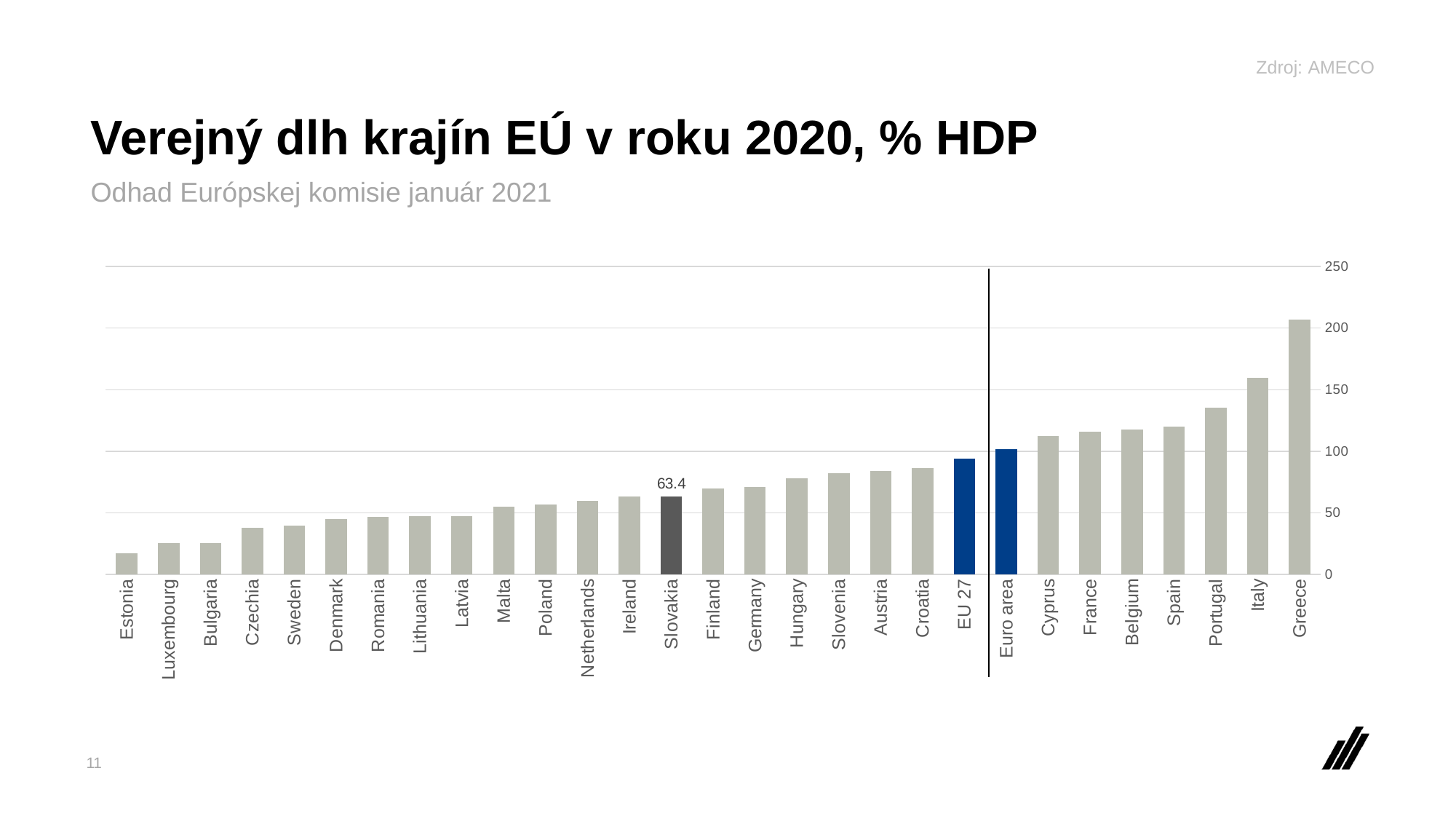
How many categories (bars) are shown on the x axis? 29 Which country has the highest public debt in the chart? Greece What type of chart is shown on the slide? bar chart Which has a larger value, Estonia or Luxembourg? Luxembourg Is the value for Italy greater or less than 150? greater Which has a larger value, Greece or Italy? Greece Do the values generally rise or fall from left to right along the x axis? rise What is the value shown for Slovakia? 63.4 Which country has the lowest public debt in the chart? Estonia Is the value for Estonia greater or less than 50? less Is the value for Greece greater or less than 200? greater